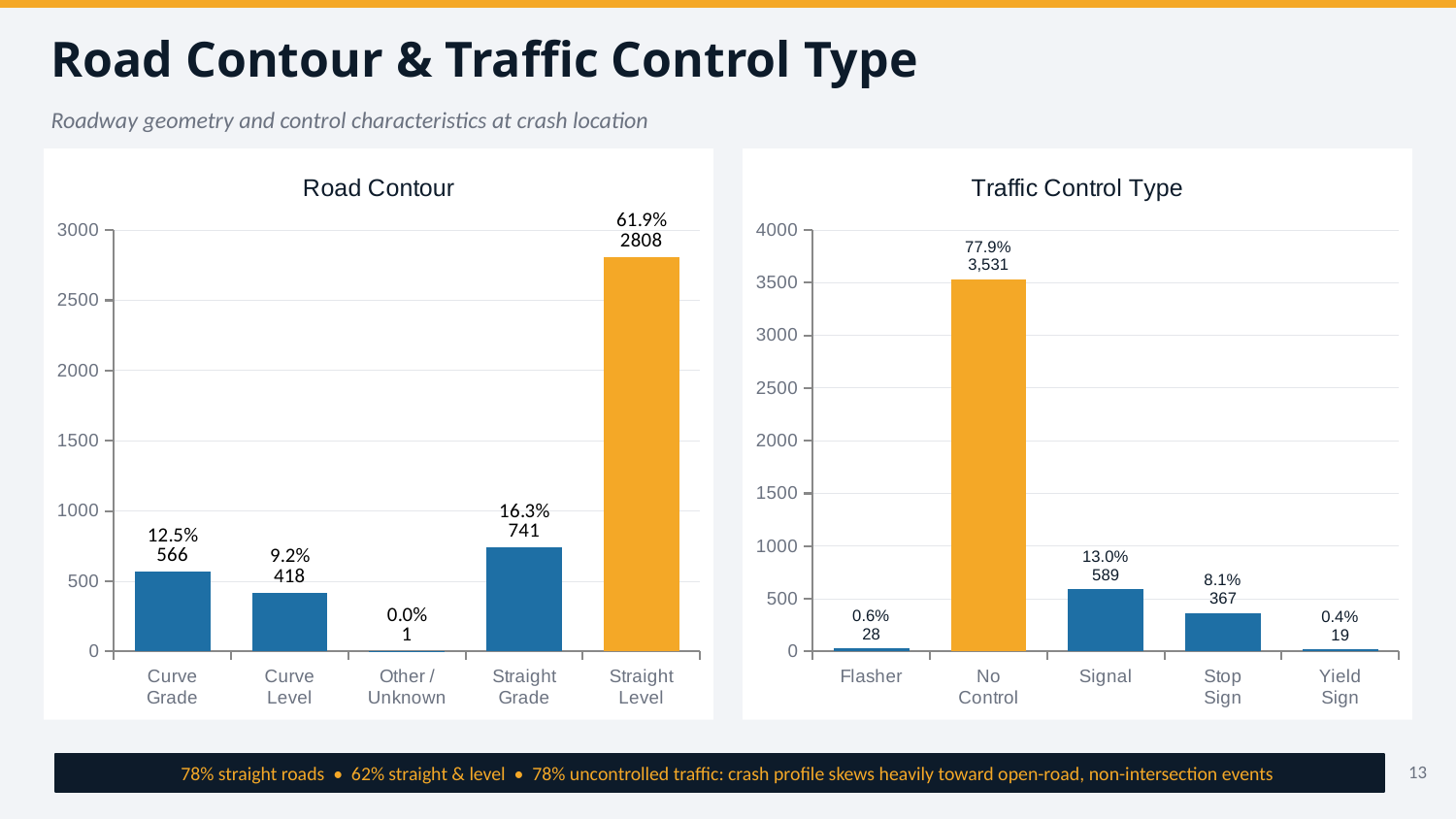
In the Road Contour chart, which category has the lowest value? Other / Unknown In the Traffic Control Type chart, which is larger, Signal or Stop Sign? Signal In the Road Contour chart, what is the value for Straight Level? 2808 In the Traffic Control Type chart, what percentage is shown for Stop Sign? 8.1% In the Traffic Control Type chart, which category has the highest value? No Control In the Road Contour chart, how many categories are shown on the x axis? 5 What kind of chart is the Traffic Control Type chart? Bar chart In the Traffic Control Type chart, what is the difference between Flasher and Yield Sign? 9 In the Road Contour chart, what is the difference between Straight Grade and Curve Level? 323 In the Road Contour chart, what percentage is shown for Curve Grade? 12.5% In the Traffic Control Type chart, what is the value for No Control? 3,531 In the Road Contour chart, which bar is coloured orange rather than blue? Straight Level